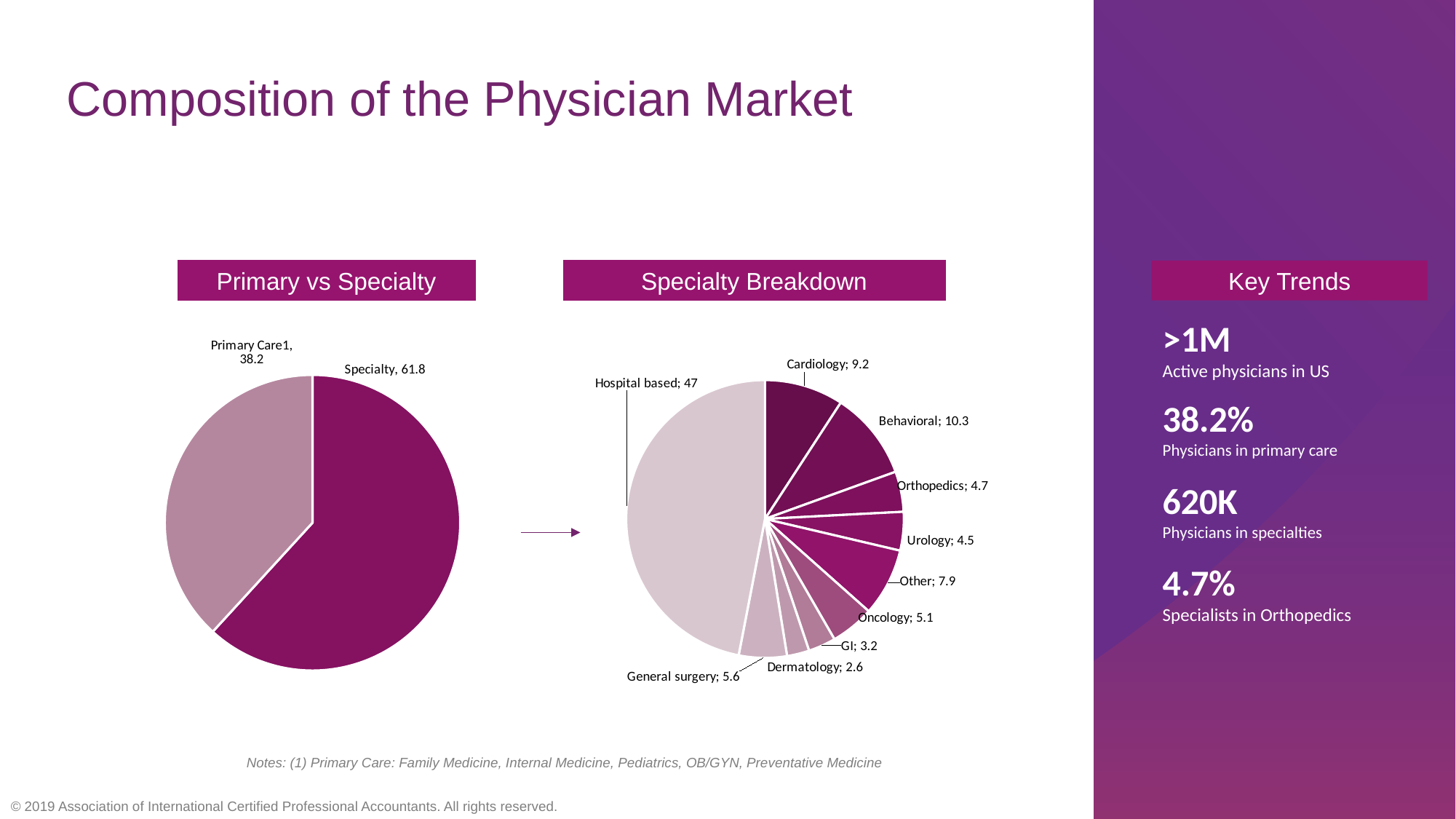
In the Primary vs Specialty chart, what is the difference between Specialty and Primary Care? 23.6 In the Specialty Breakdown chart, which category has the largest slice? Hospital based In the Specialty Breakdown chart, what is the value for Hospital based? 47 What kind of chart is the Primary vs Specialty chart? Pie chart In the Specialty Breakdown chart, which category has the smallest slice? Dermatology In the Primary vs Specialty chart, what is the value for Specialty? 61.8 In the Specialty Breakdown chart, how many categories are shown? 10 In the Primary vs Specialty chart, what is the value for Primary Care? 38.2 In the Specialty Breakdown chart, what is the difference between Behavioral and Cardiology? 1.1 In the Specialty Breakdown chart, which is larger, Cardiology or Other? Cardiology In the Specialty Breakdown chart, what is the value for Behavioral? 10.3 In the Specialty Breakdown chart, what is the value for GI? 3.2